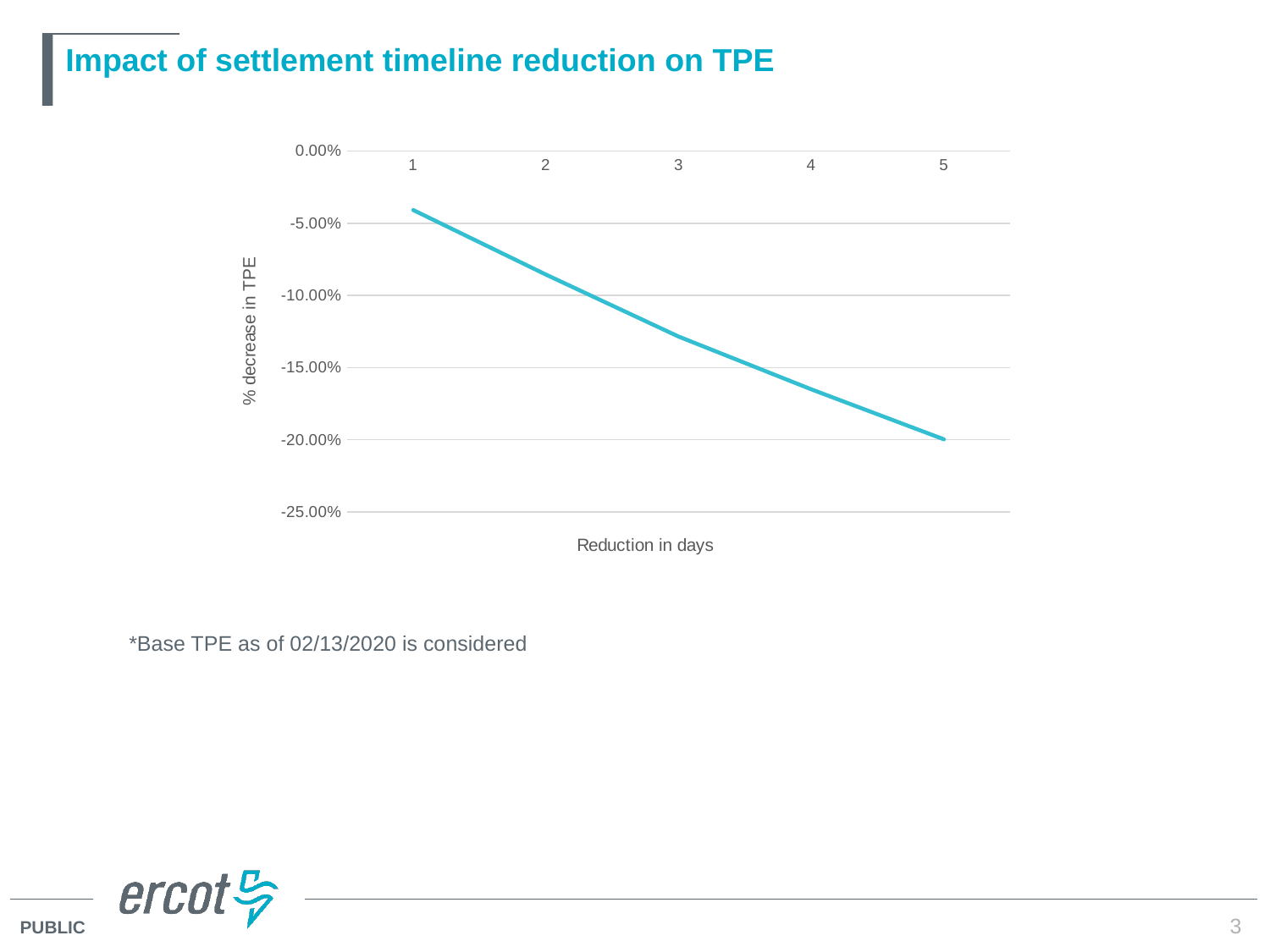
How many data points are plotted on the line? 5 Which has the larger (less negative) % decrease in TPE: a reduction of 2 days or a reduction of 4 days? 2 days Is the value for a reduction of 5 days greater or less than -15.00%? less At which reduction in days is the % decrease in TPE the highest (least negative)? 1 At which reduction in days is the % decrease in TPE the lowest (most negative)? 5 What is the label of the vertical axis? % decrease in TPE What kind of chart is shown on the slide? line chart Do the values rise or fall as the reduction in days increases from 1 to 5? fall What is the label of the horizontal axis? Reduction in days Is the value for a reduction of 2 days greater or less than -10.00%? greater Is the value for a reduction of 3 days greater or less than -10.00%? less